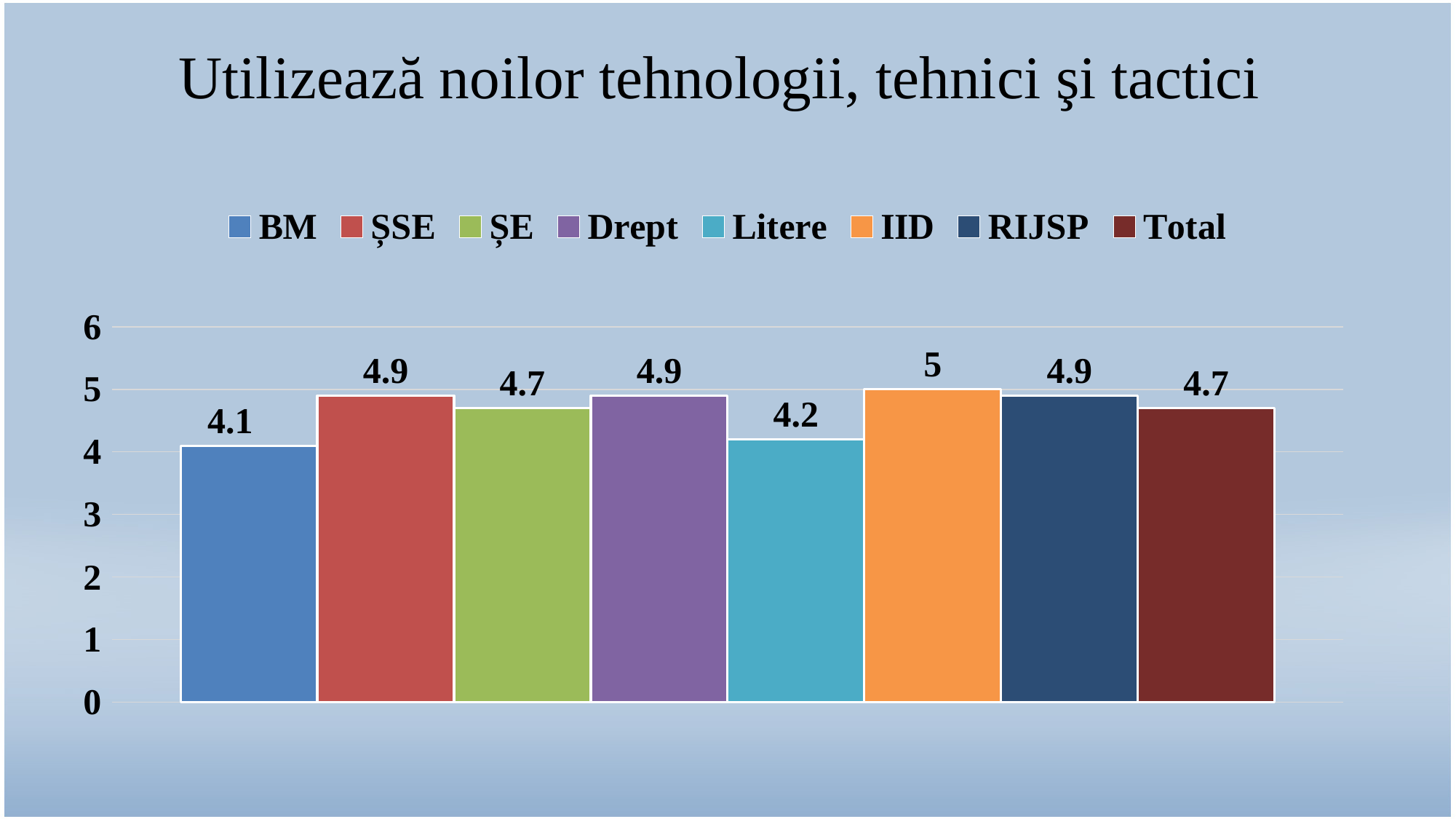
Which series has the lowest value? BM Which series has the highest value? IID What is the value for Total? 4.7 What is the value for IID? 5 What is the difference between the values for IID and BM? 0.9 Which is larger, the value for ŞE or the value for Litere? ŞE Is the value for Drept greater or less than 4? greater What kind of chart is shown on the slide? bar chart What is the value for Litere? 4.2 How many series does the legend list? 8 What is the value for BM? 4.1 What is the title of the chart? Utilizează noilor tehnologii, tehnici şi tactici